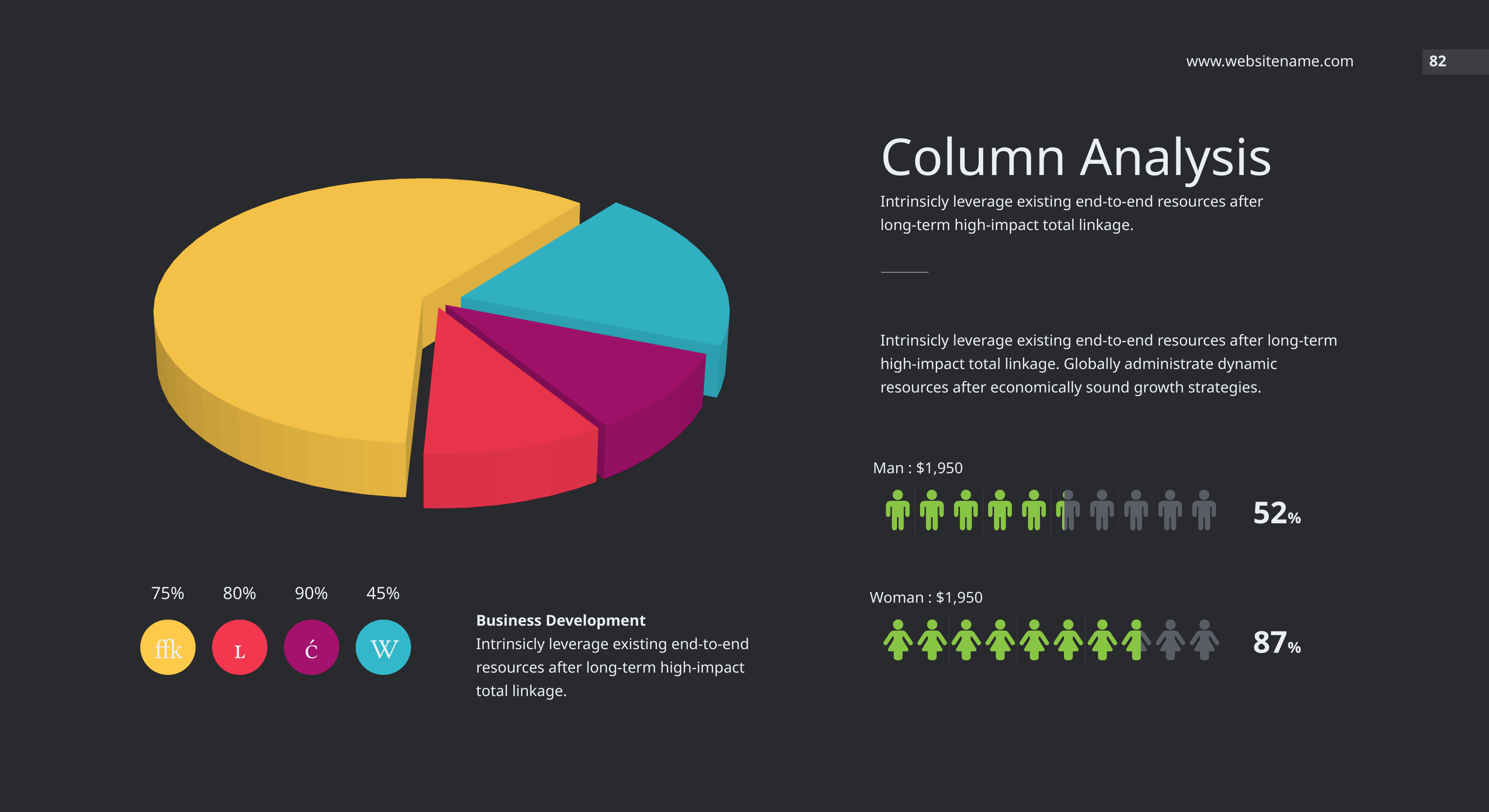
Which colour slice is the largest in the pie chart? yellow What is the difference between the percentage above the magenta circle and the percentage above the cyan circle in the legend below the pie chart? 45% Which slice is larger in the pie chart, the yellow slice or the cyan slice? yellow What is the title of the slide containing the pie chart? Column Analysis What kind of chart is shown on the left of the slide? pie chart How many slices does the pie chart have? 4 What percentage is printed above the cyan circle in the legend below the pie chart? 45% In the pictograph on the right, what percentage is shown for Man? 52% Which colour circle in the legend below the pie chart has the highest percentage printed above it? magenta (90%) Which colour circle in the legend below the pie chart has the lowest percentage printed above it? cyan (45%) In the pictograph on the right, what percentage is shown for Woman? 87% What percentage is printed above the yellow circle in the legend below the pie chart? 75%